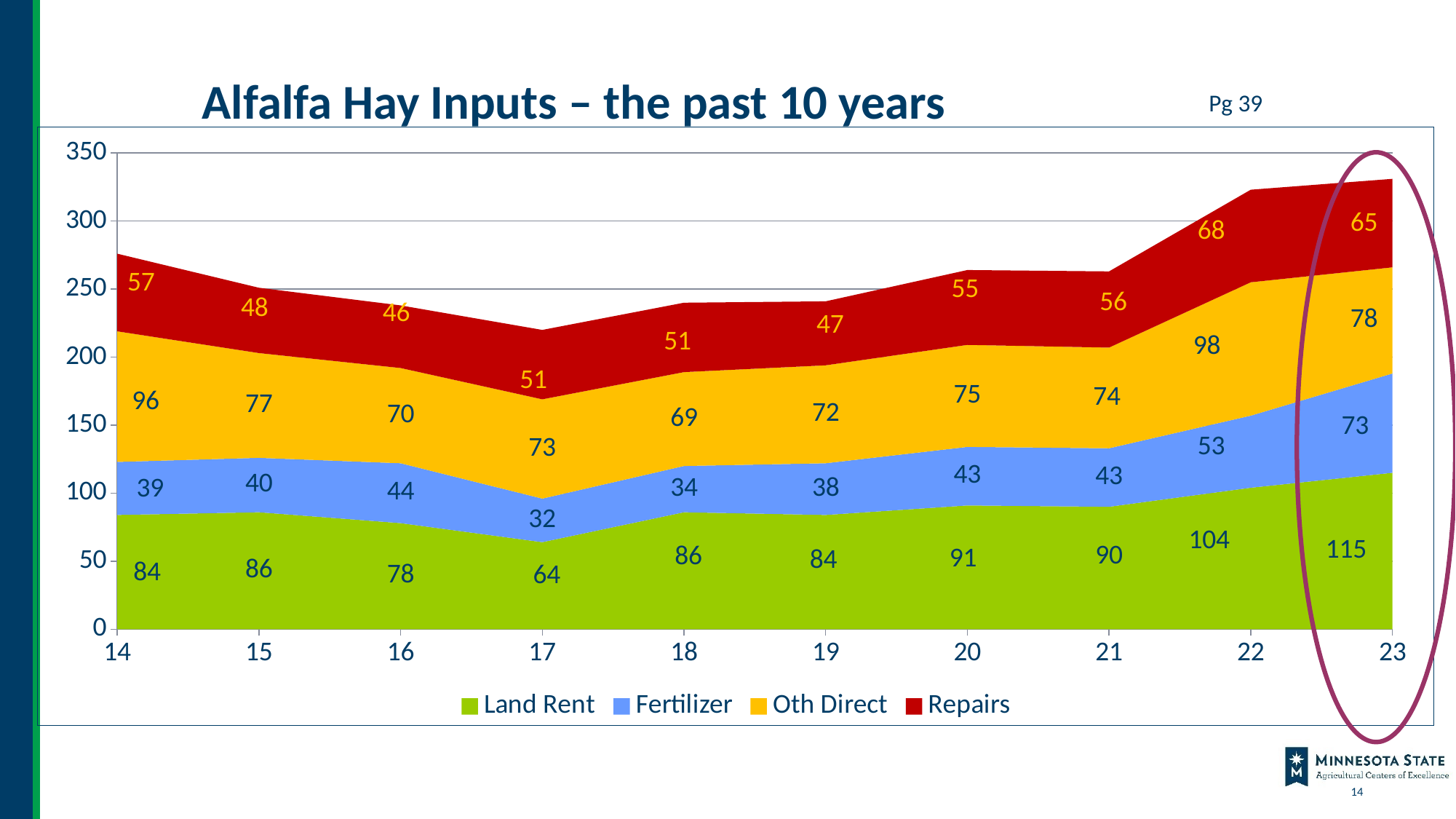
What is the Fertilizer value for year 17? 32 How many years are shown on the x axis? 10 What is the Oth Direct value for year 14? 96 What is the total of all four inputs for year 23? 331 How many series does the legend list? 4 In which year is Fertilizer highest? 23 What is the Repairs value for year 22? 68 What kind of chart is shown on the slide? Stacked area chart In which year is Land Rent lowest? 17 Which is larger, the Oth Direct value for year 22 or for year 23? Year 22 What is the Land Rent value for year 23? 115 What is the difference between the Land Rent values for year 23 and year 14? 31